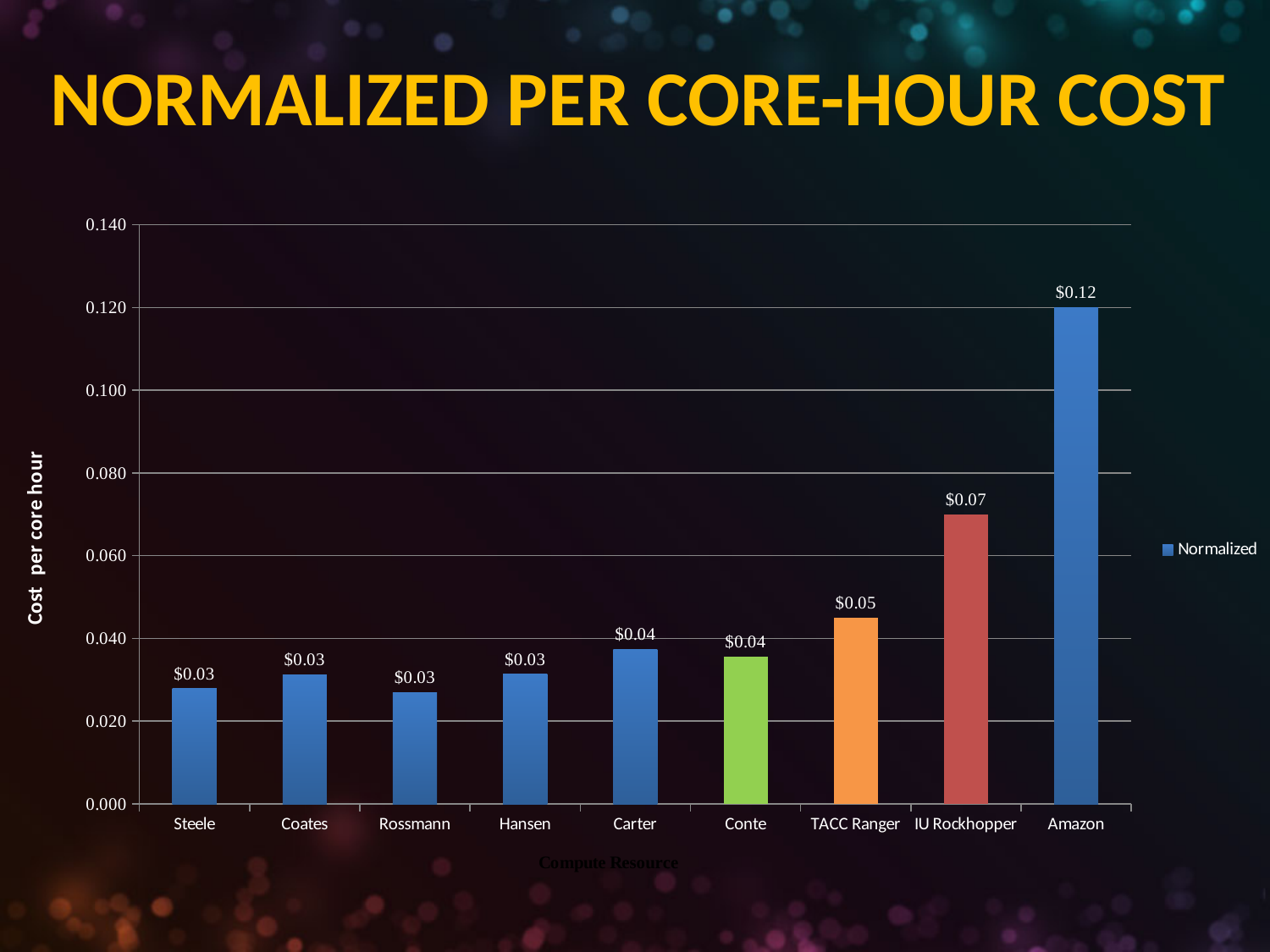
What is the value for TACC Ranger? $0.05 How many series does the legend list? 1 Is the value for Steele greater or less than 0.040? less What kind of chart is shown on the slide? Bar chart What is the difference between the values for Amazon and IU Rockhopper? $0.05 What is the value for IU Rockhopper? $0.07 What is the value for Amazon? $0.12 Is the value for Amazon greater or less than 0.100? greater Which is larger, the value for TACC Ranger or the value for Carter? TACC Ranger How many compute resources are shown on the x axis? 9 Which compute resource has the highest normalized per core-hour cost? Amazon What is the value for Carter? $0.04